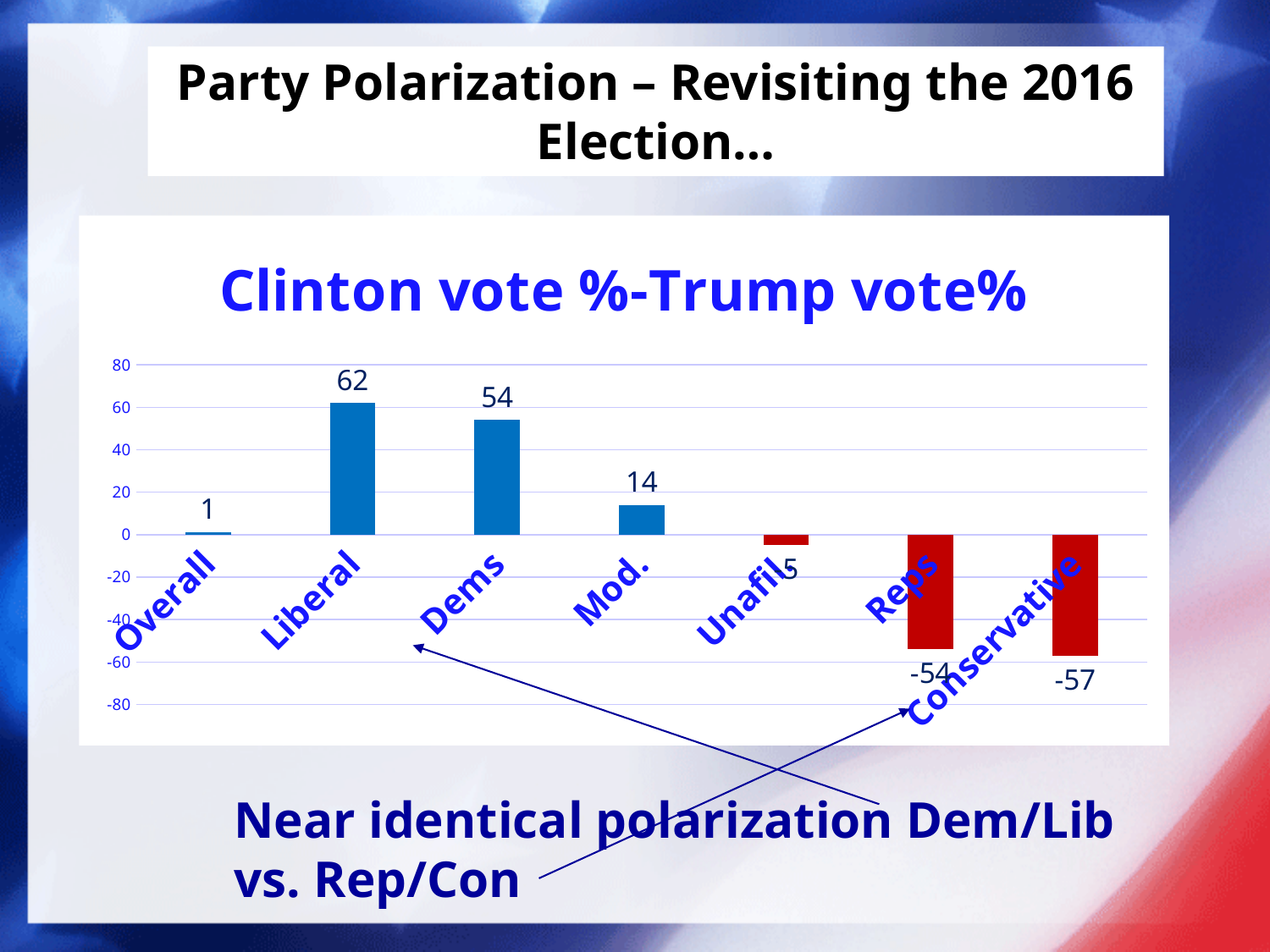
Which is larger, the value for Dems or the value for Mod.? Dems Which category has the highest value in the chart? Liberal What is the value for Mod. in the chart? 14 What is the value for Liberal in the chart? 62 How many categories are shown on the x axis of the chart? 7 What is the difference between the values for Liberal and Dems? 8 Is the value for Unafil greater or less than 0? less What is the value for Dems in the chart? 54 What is the value for Conservative in the chart? -57 What is the value for Reps in the chart? -54 Which category has the lowest value in the chart? Conservative What is the title of the chart? Clinton vote %-Trump vote%